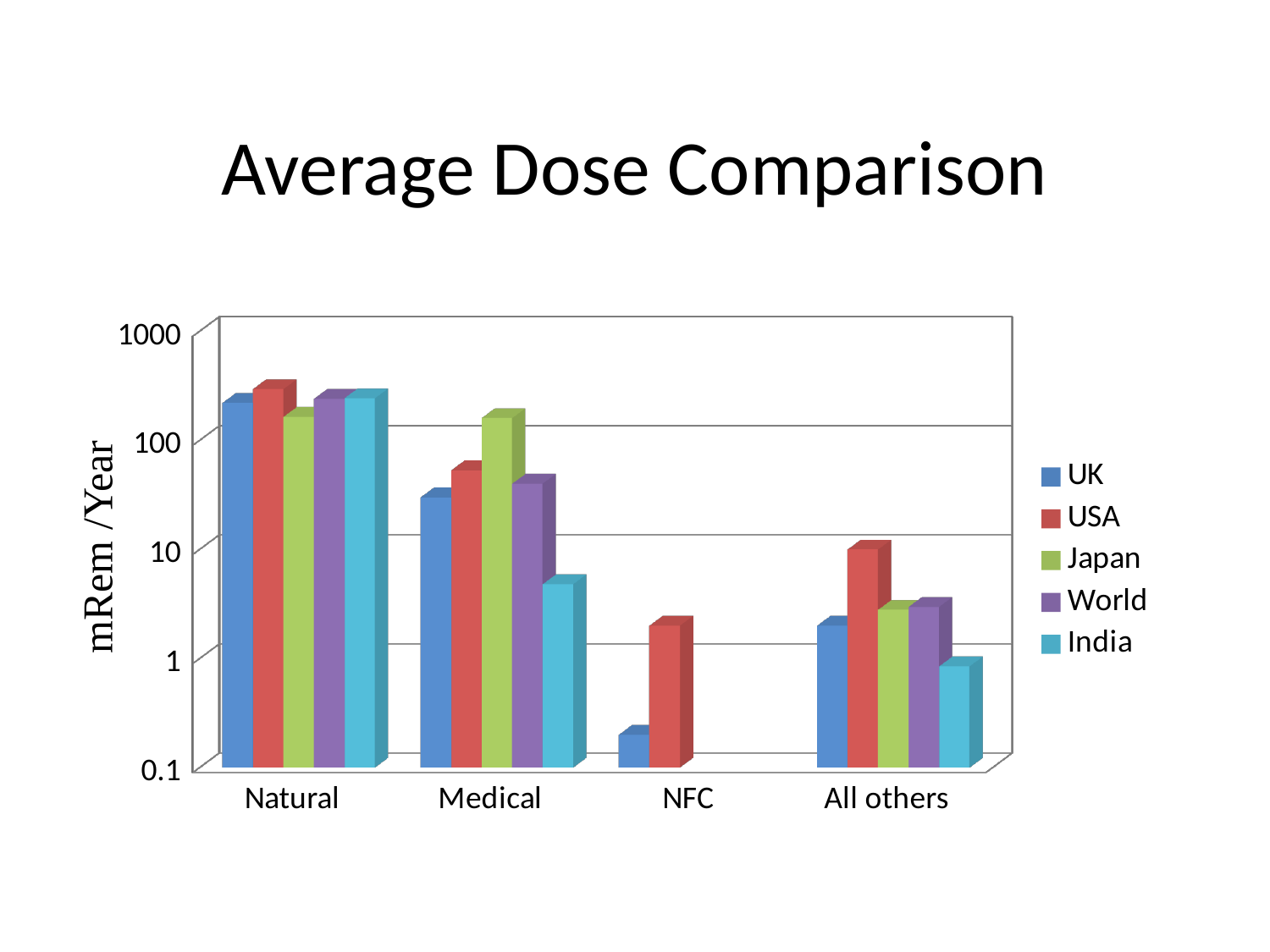
What is the title of the chart? Average Dose Comparison What is the label on the vertical axis? mRem /Year Is the value for India in the Medical category greater or less than 10? less What kind of chart is shown on the slide? bar chart Is the value for Japan in the Medical category greater or less than 100? greater How many series does the legend list? 5 Is the value for UK in the NFC category greater or less than 1? less Which series has the highest value in the Medical category? Japan In the NFC category, which is larger, the value for UK or the value for USA? USA How many categories are shown on the x axis? 4 Which series has the lowest value in the Medical category? India Which series has the highest value in the All others category? USA